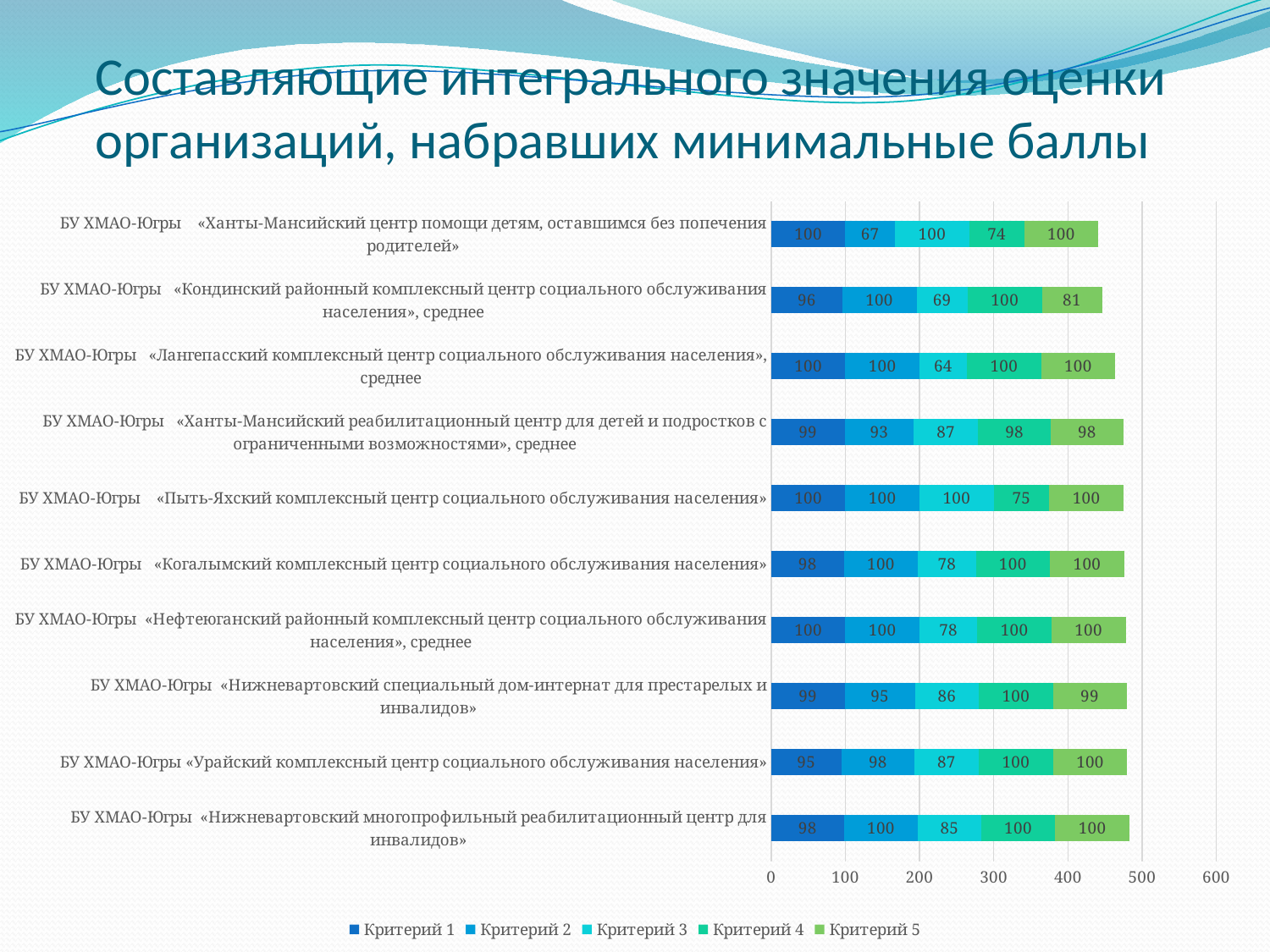
Which is larger: Критерий 1 for БУ ХМАО-Югры «Кондинский районный комплексный центр социального обслуживания населения», среднее or Критерий 1 for БУ ХМАО-Югры «Урайский комплексный центр социального обслуживания населения»? Кондинский районный комплексный центр социального обслуживания населения What is the value of Критерий 4 for БУ ХМАО-Югры «Пыть-Яхский комплексный центр социального обслуживания населения»? 75 What is the value of Критерий 3 for БУ ХМАО-Югры «Лангепасский комплексный центр социального обслуживания населения», среднее? 64 How many organizations (categories) are plotted in the chart? 10 What is the value of Критерий 2 for БУ ХМАО-Югры «Ханты-Мансийский центр помощи детям, оставшимся без попечения родителей»? 67 Which organization has the lowest value for Критерий 2? БУ ХМАО-Югры «Ханты-Мансийский центр помощи детям, оставшимся без попечения родителей» How many series does the legend list? 5 What kind of chart is shown on the slide? Stacked bar chart What is the total of the stacked bar for БУ ХМАО-Югры «Нижневартовский многопрофильный реабилитационный центр для инвалидов»? 483 Is the total of the stacked bar for БУ ХМАО-Югры «Ханты-Мансийский центр помощи детям, оставшимся без попечения родителей» greater or less than 500? less What is the value of Критерий 5 for БУ ХМАО-Югры «Кондинский районный комплексный центр социального обслуживания населения», среднее? 81 What is the difference between Критерий 3 for БУ ХМАО-Югры «Урайский комплексный центр социального обслуживания населения» and Критерий 3 for БУ ХМАО-Югры «Лангепасский комплексный центр социального обслуживания населения», среднее? 23